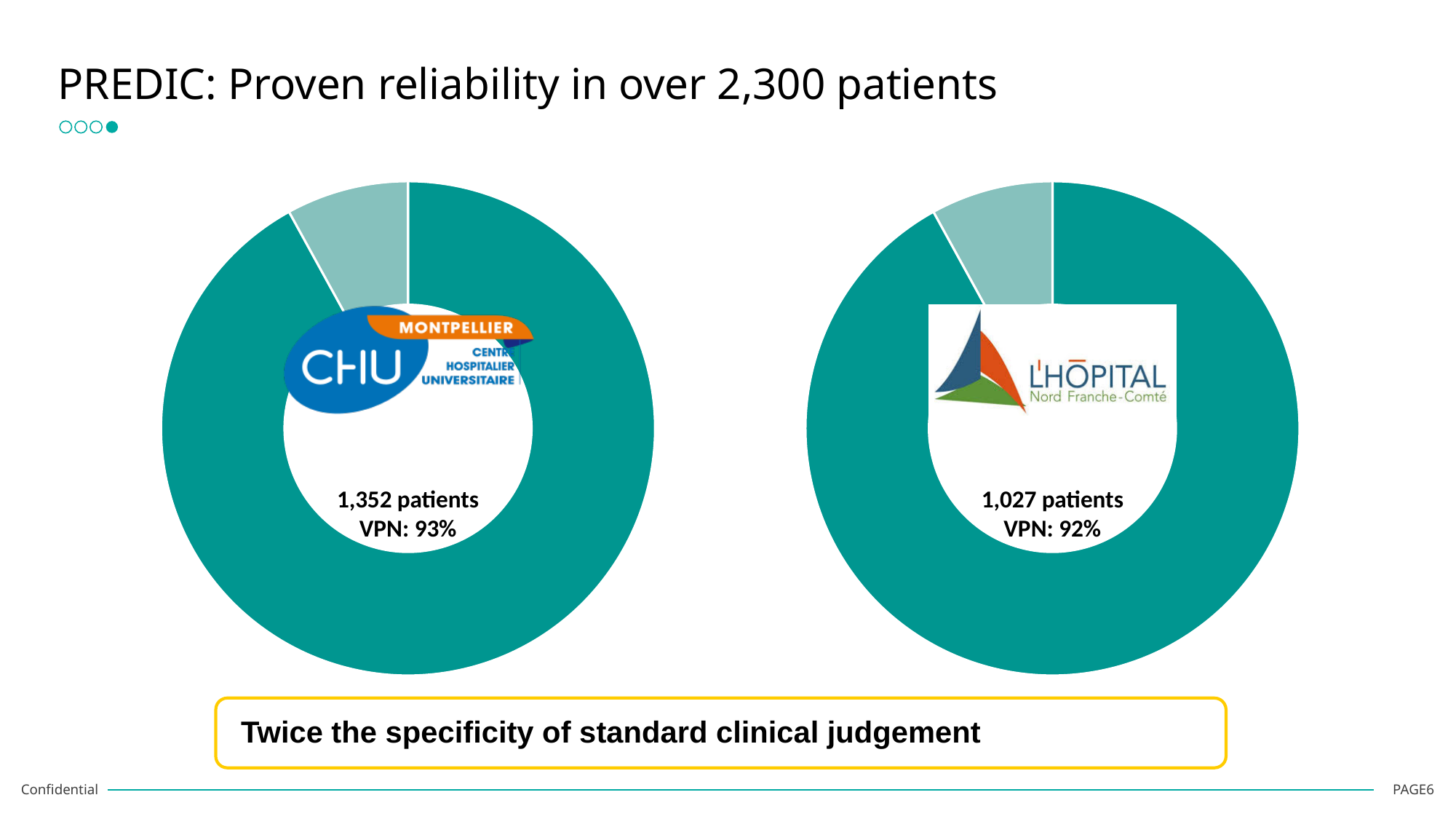
Which hospital's logo appears in the centre of the right chart? L'Hôpital Nord Franche-Comté In the left chart, which slice is larger, the dark teal one or the light teal one? Dark teal How many slices does each donut chart contain? 2 In the left chart (CHU Montpellier), how many patients are reported? 1,352 patients What kind of chart is shown on the left of the slide? Pie (donut) chart Which chart reports more patients, the left (CHU Montpellier) or the right (L'Hôpital Nord Franche-Comté)? Left (CHU Montpellier) What is the difference in patient numbers between the left chart (1,352) and the right chart (1,027)? 325 How many donut charts are shown on the slide? 2 Which chart shows the higher VPN, the left (CHU Montpellier) or the right (L'Hôpital Nord Franche-Comté)? Left (CHU Montpellier) What VPN value is shown in the right chart (L'Hôpital Nord Franche-Comté)? 92% In the right chart (L'Hôpital Nord Franche-Comté), how many patients are reported? 1,027 patients What VPN value is shown in the left chart (CHU Montpellier)? 93%